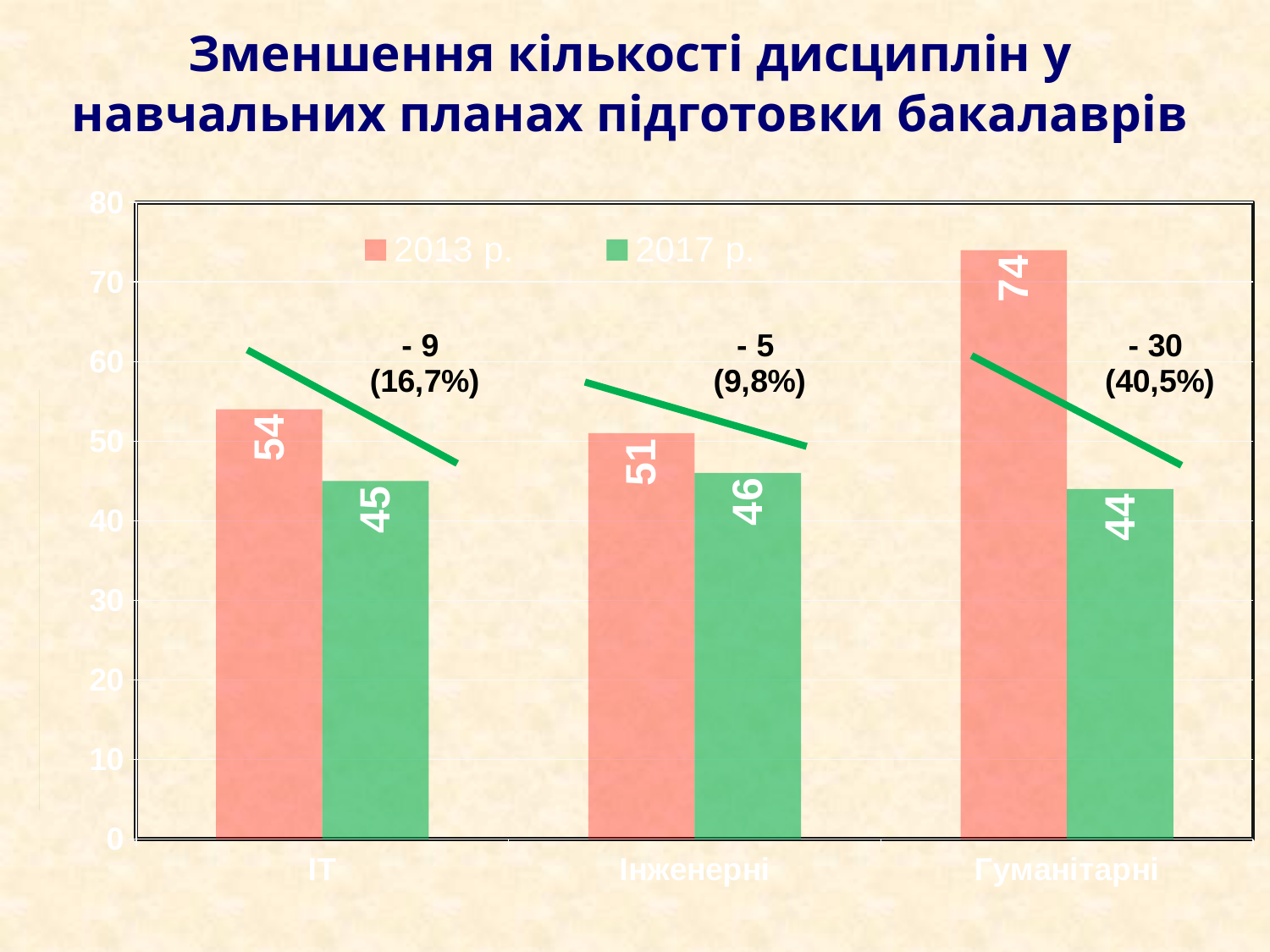
What is the value for Інженерні in the 2013 р. series? 51 Is the 2013 р. value for Гуманітарні greater or less than 70? greater What is the value for Гуманітарні in the 2017 р. series? 44 Which category has the lowest value in the 2017 р. series? Гуманітарні Which is larger for Інженерні: the 2013 р. value or the 2017 р. value? 2013 р. What is the difference between the 2013 р. and 2017 р. values for Гуманітарні? 30 How many series does the legend list? 2 How many categories are shown on the x axis? 3 Which category has the highest value in the 2013 р. series? Гуманітарні What kind of chart is shown on the slide? bar chart What percentage decrease is annotated for the ІТ category? 16,7% What is the value for ІТ in the 2013 р. series? 54